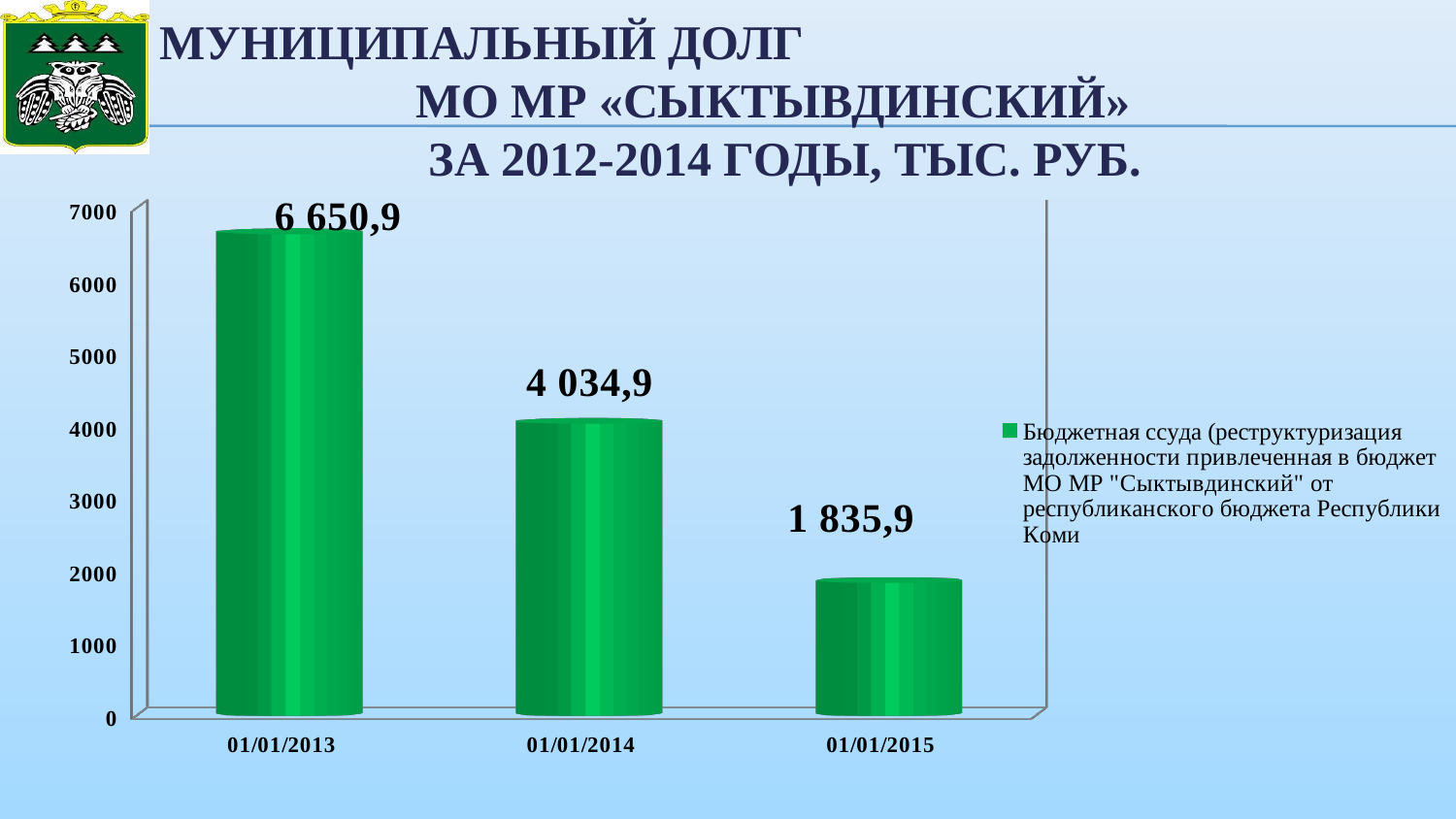
Is the value for 01/01/2014 greater or less than 5000? less What kind of chart is shown on the slide? bar chart What is the difference between the values for 01/01/2013 and 01/01/2014? 2 616,0 Which date has the highest value? 01/01/2013 Do the values rise or fall from 01/01/2013 to 01/01/2015? fall Which is larger, the value for 01/01/2014 or the value for 01/01/2015? 01/01/2014 What is the value of the bar for 01/01/2014? 4 034,9 What is the value of the bar for 01/01/2015? 1 835,9 How many bars are shown in the chart? 3 Which date has the lowest value? 01/01/2015 What is the value of the bar for 01/01/2013? 6 650,9 What is the difference between the values for 01/01/2014 and 01/01/2015? 2 199,0